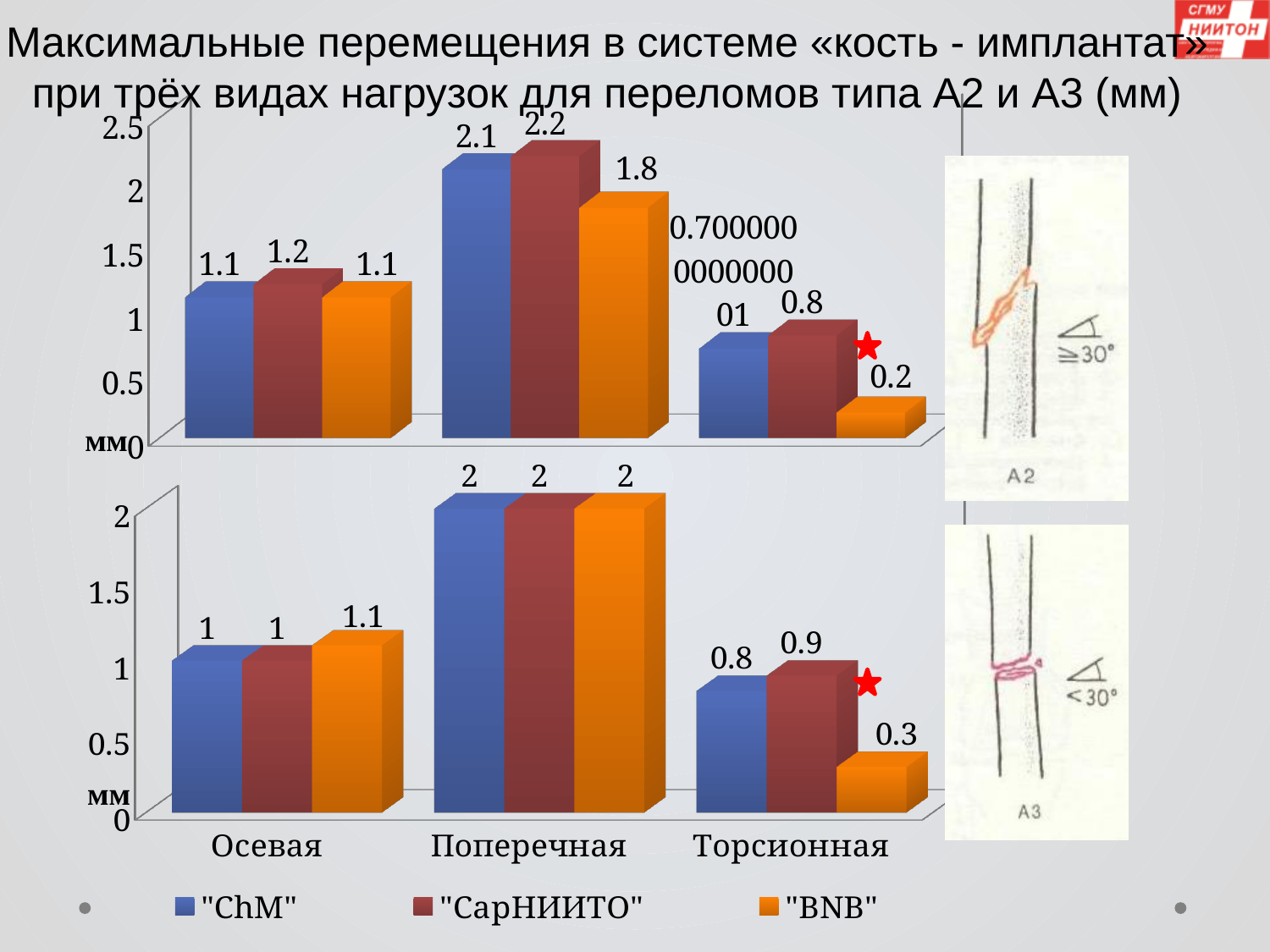
How many categories are shown on the x axis of the bottom chart? 3 In the bottom chart (A3), which is larger in the Торсионная category: "ChM" or "СарНИИТО"? "СарНИИТО" How many series does the legend list? 3 In the bottom chart (A3), what is the value for "BNB" in the Торсионная category? 0.3 In the top chart (A2), what is the value for "СарНИИТО" in the middle (Поперечная) group? 2.2 In the top chart (A2), what is the difference between the "СарНИИТО" and "BNB" values in the middle (Поперечная) group? 0.4 In the top chart (A2), which series has the highest value in the middle (Поперечная) group? "СарНИИТО" What type of chart is the bottom chart? Bar chart In the bottom chart (A3), which series has the lowest value in the Торсионная category? "BNB" In the top chart (A2), what is the value for "BNB" in the rightmost (Торсионная) group? 0.2 In the bottom chart (A3), what is the value for "BNB" in the Осевая category? 1.1 In the bottom chart (A3), what is the value for "СарНИИТО" in the Торсионная category? 0.9